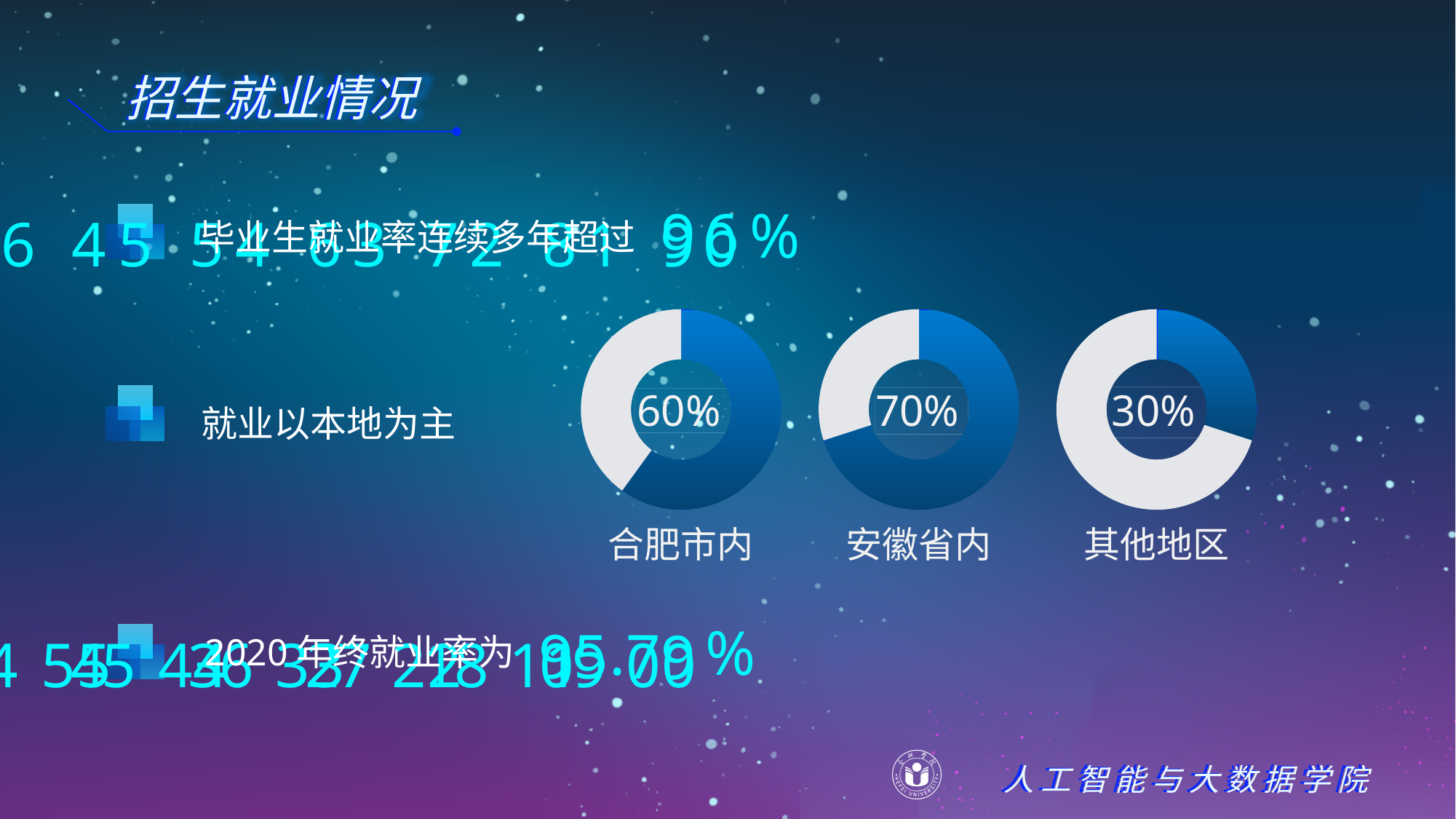
What is the difference between the percentage in the 安徽省内 chart and the percentage in the 合肥市内 chart? 10% Which is larger, the percentage in the 安徽省内 chart or the percentage in the 其他地区 chart? 安徽省内 Among the three donut charts (合肥市内, 安徽省内, 其他地区), which shows the lowest percentage? 其他地区 What value is shown in the 合肥市内 donut chart? 60% What value is shown in the 安徽省内 donut chart? 70% How many donut charts are shown on the slide? 3 Which is larger, the percentage in the 合肥市内 chart or the percentage in the 其他地区 chart? 合肥市内 What value is shown in the 其他地区 donut chart? 30% In the 其他地区 donut chart, what colour is the filled 30% portion? Blue What kind of chart is used to show the 合肥市内, 安徽省内 and 其他地区 percentages? Donut chart Among the three donut charts (合肥市内, 安徽省内, 其他地区), which shows the highest percentage? 安徽省内 What is the difference between the percentage in the 合肥市内 chart and the percentage in the 其他地区 chart? 30%